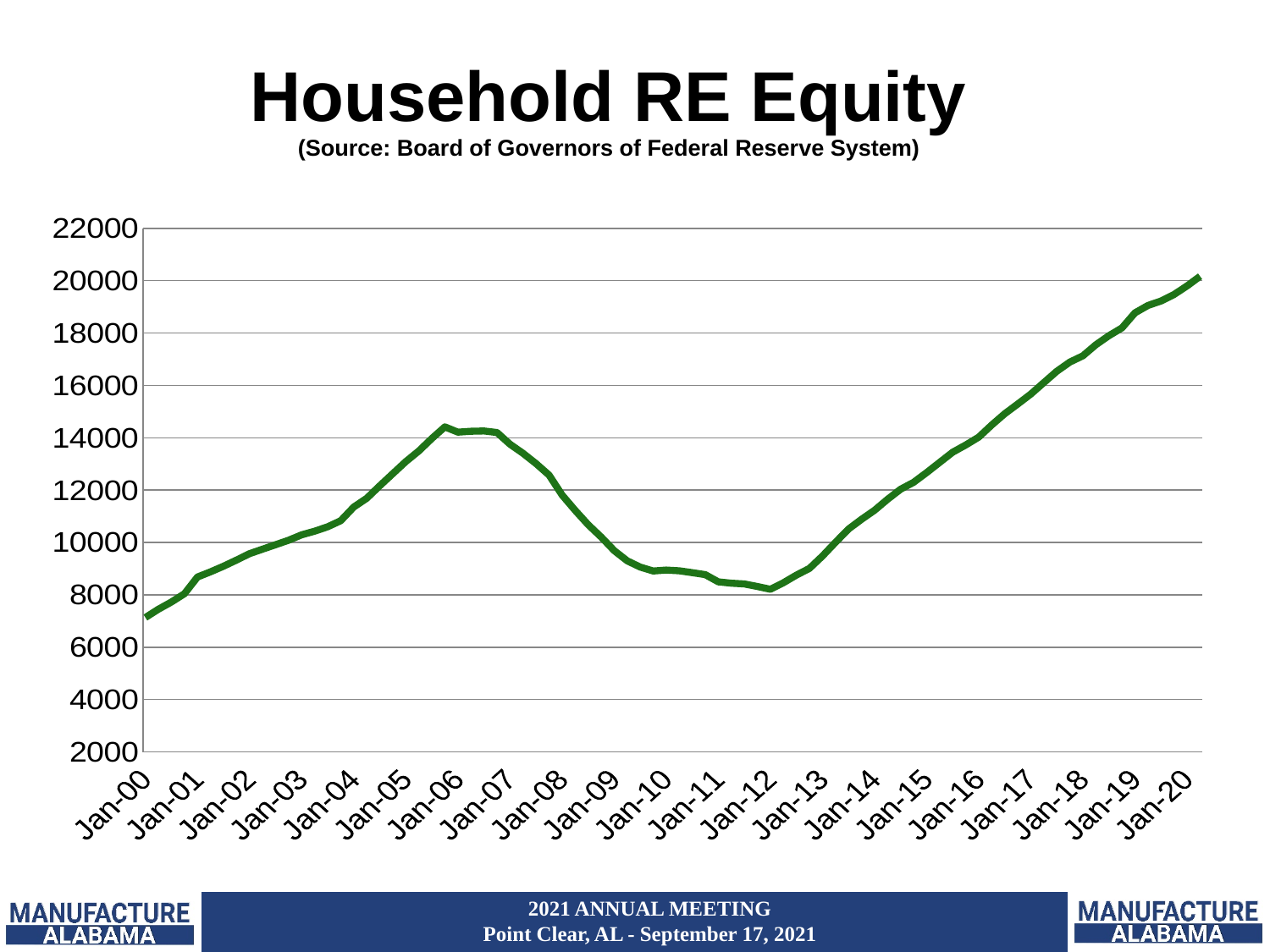
What source is cited for the chart data? Board of Governors of Federal Reserve System What kind of chart is shown on the slide? line chart Is the value at Jan-12 greater or less than 10000? less Does the line rise or fall between Jan-12 and Jan-20? rise How many date labels are shown on the x axis? 21 Is the value at Jan-20 greater or less than 18000? greater What is the title of the chart? Household RE Equity At which x-axis date does the line have its lowest value? Jan-00 Is the value at Jan-06 greater or less than 12000? greater At which x-axis date does the line reach its highest value? Jan-20 Which is larger, the value at Jan-06 or the value at Jan-12? Jan-06